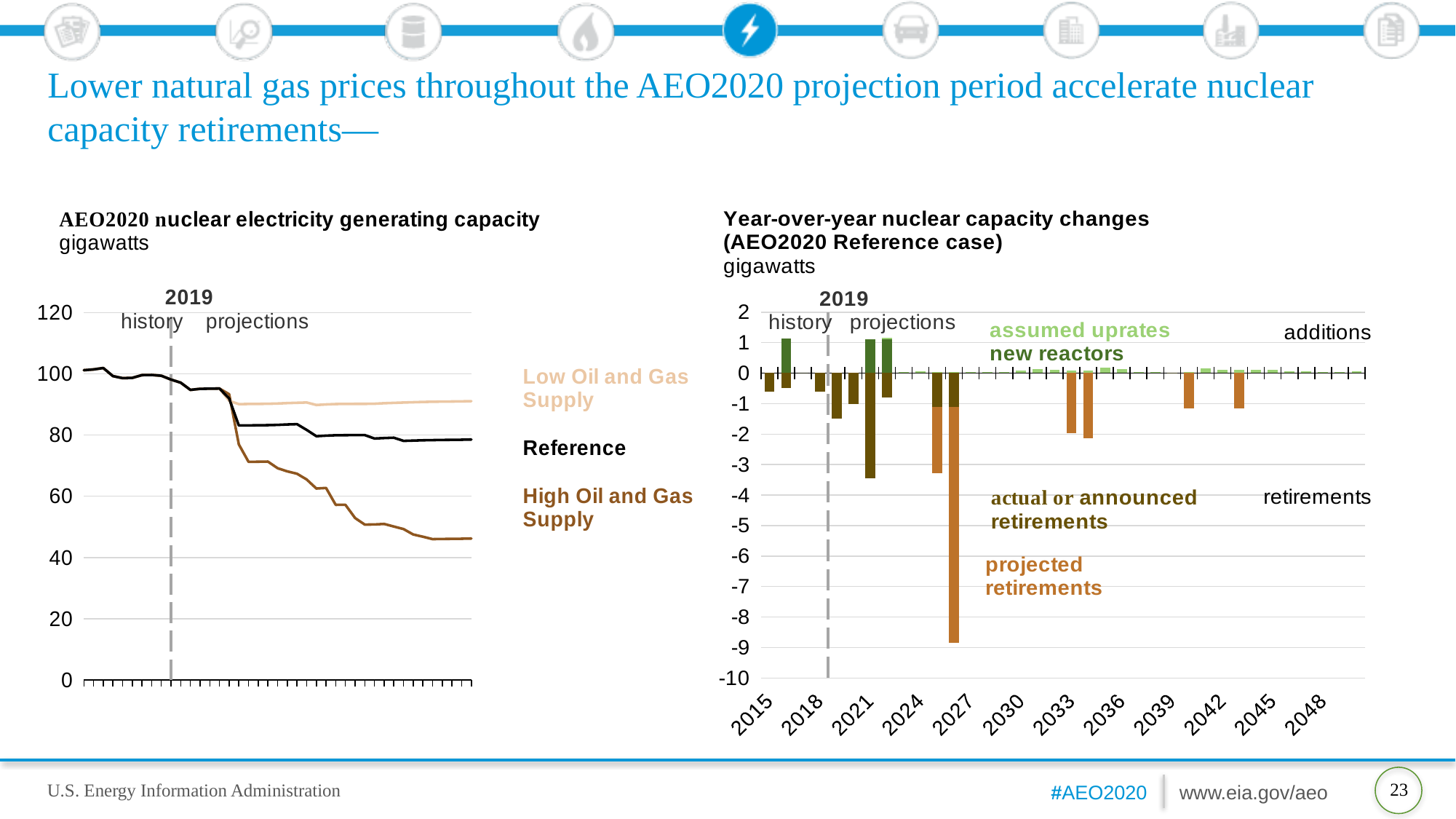
What kind of chart is the right chart, 'Year-over-year nuclear capacity changes (AEO2020 Reference case)'? bar chart In the left chart, does the Reference series rise or fall over the projection period? fall In the right chart, which year marks the boundary between history and projections? 2019 In the left chart, which series has the highest capacity at the end of the projection period? Low Oil and Gas Supply What kind of chart is the left chart, 'AEO2020 nuclear electricity generating capacity'? line chart In the left chart, is the Low Oil and Gas Supply value at the end of the projection period greater or less than 80 gigawatts? greater In the left chart, how many series are listed in the legend? 3 In the right chart, how many categories of capacity change are labelled in the legend? 4 In the left chart, is the High Oil and Gas Supply value at the end of the projection period greater or less than 60 gigawatts? less In the left chart, which series has the lowest capacity at the end of the projection period? High Oil and Gas Supply In the left chart, at the end of the projection period, which is larger: the Reference value or the High Oil and Gas Supply value? Reference